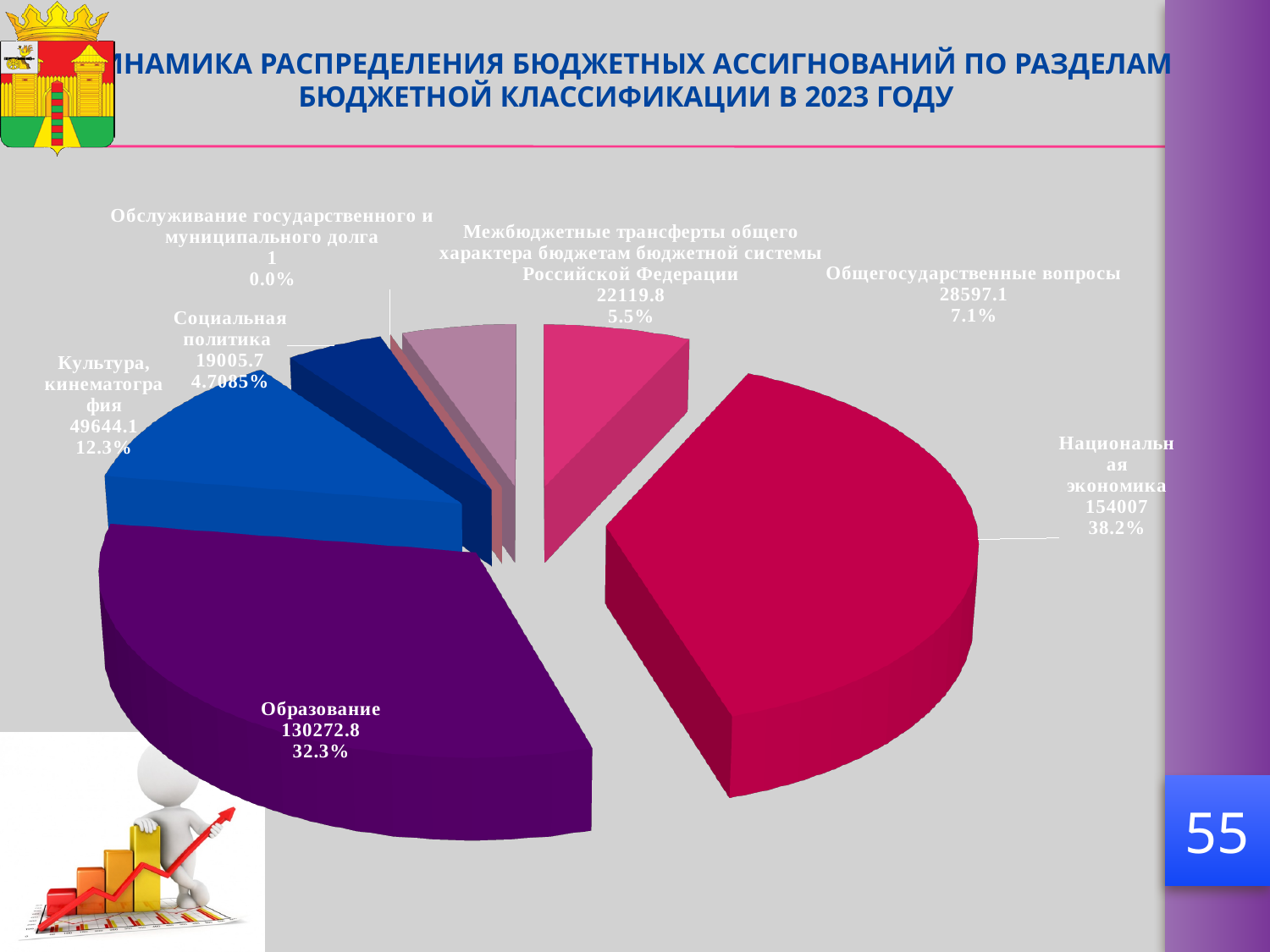
What value is shown for Образование? 130272.8 Which is larger, Образование or Культура, кинематография? Образование What value is shown for Национальная экономика? 154007 What kind of chart is shown on the slide? Pie chart Which category has the smallest slice of the pie? Обслуживание государственного и муниципального долга What share of the pie does Социальная политика represent? 4.7085% What value is shown for Культура, кинематография? 49644.1 Which category has the largest slice of the pie? Национальная экономика What share of the pie does Межбюджетные трансферты общего характера бюджетам бюджетной системы Российской Федерации represent? 5.5% Which is larger, Общегосударственные вопросы or Межбюджетные трансферты общего характера бюджетам бюджетной системы Российской Федерации? Общегосударственные вопросы What is the difference between the values for Общегосударственные вопросы and Межбюджетные трансферты общего характера бюджетам бюджетной системы Российской Федерации? 6477.3 What is the difference between the values for Национальная экономика and Образование? 23734.2